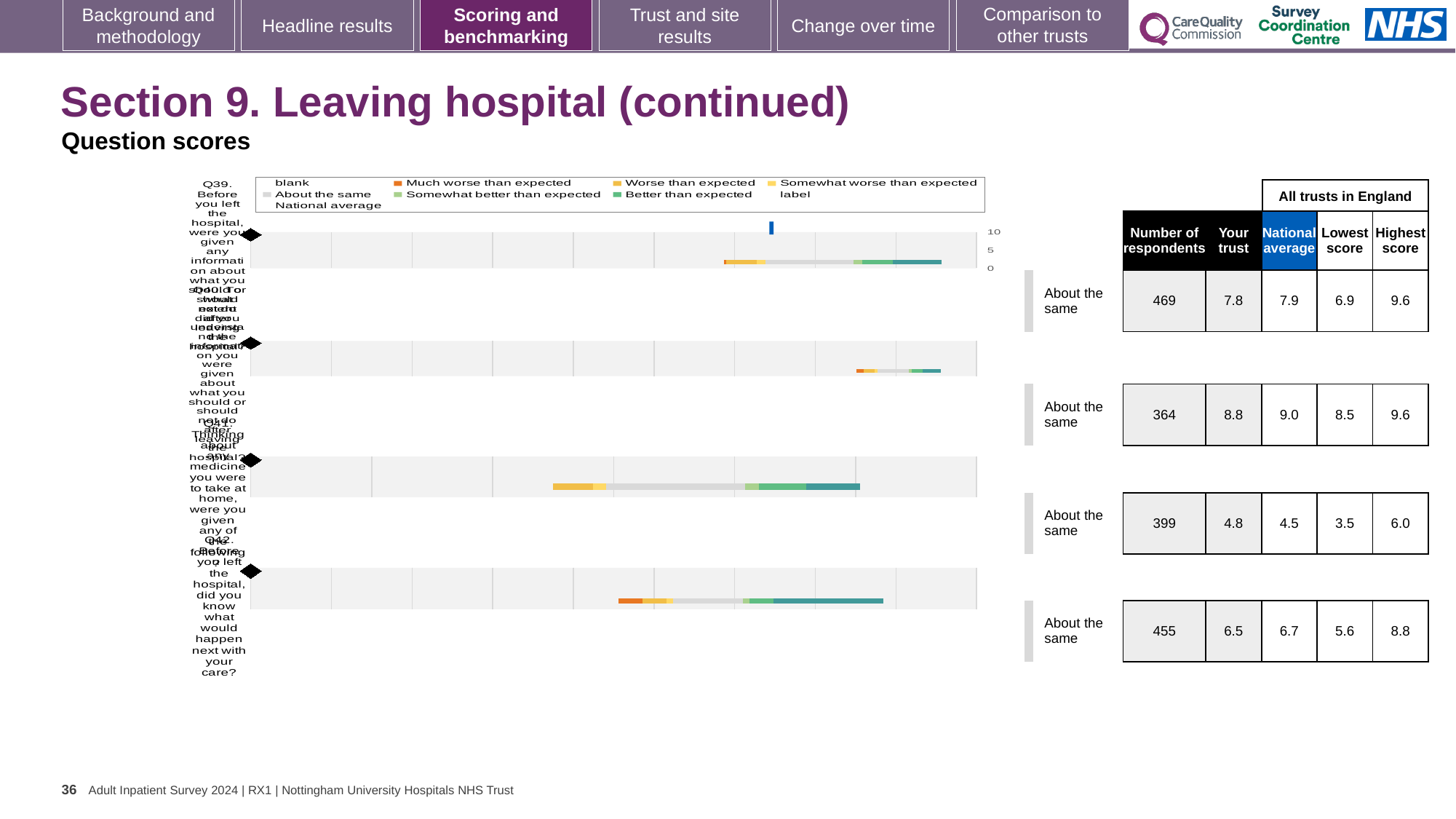
In the table next to the chart, what is the national average for Q39 (the first row)? 7.9 In the table next to the chart, what is the highest score in England for Q42 (the last row)? 8.8 In the table next to the chart, how many respondents are listed for Q42 (the last row)? 455 In the table next to the chart, what is the 'Your trust' score for Q39 (the first row)? 7.8 What is the difference between the 'Your trust' score and the national average for the third row? 0.3 How many question rows are plotted in the chart? 4 What kind of chart is used to show the question scores on this slide? bar chart What benchmark category is shown beside each of the four question rows? About the same For Q42 (the last row), is the 'Your trust' score or the national average larger? national average Which row in the table has the lowest 'Your trust' score? the third row (4.8) In the table next to the chart, what is the lowest score in England for the third row? 3.5 Which row in the table has the highest 'Your trust' score? the second row (8.8)